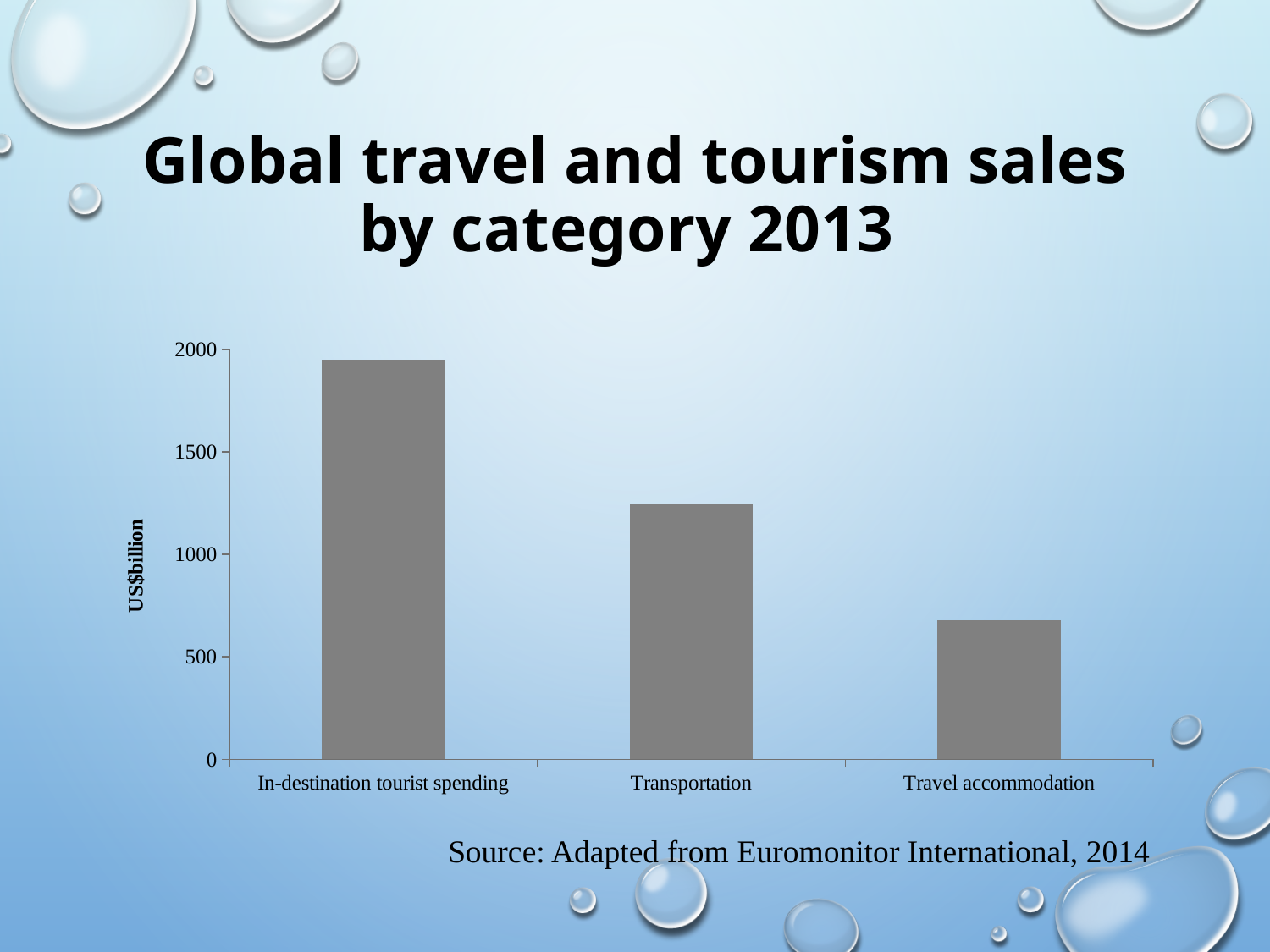
Is the value for In-destination tourist spending greater or less than 1500? greater Is the value for Travel accommodation greater or less than 1000? less Do the values rise or fall moving from left to right along the x axis? fall Which category has the highest value? In-destination tourist spending Is the value for Travel accommodation greater or less than 500? greater How many categories are shown on the x axis of the chart? 3 Which category has the lowest value? Travel accommodation What type of chart is shown on the slide? bar chart Which is larger, the value for Transportation or the value for Travel accommodation? Transportation What is the label on the vertical axis of the chart? US$billion